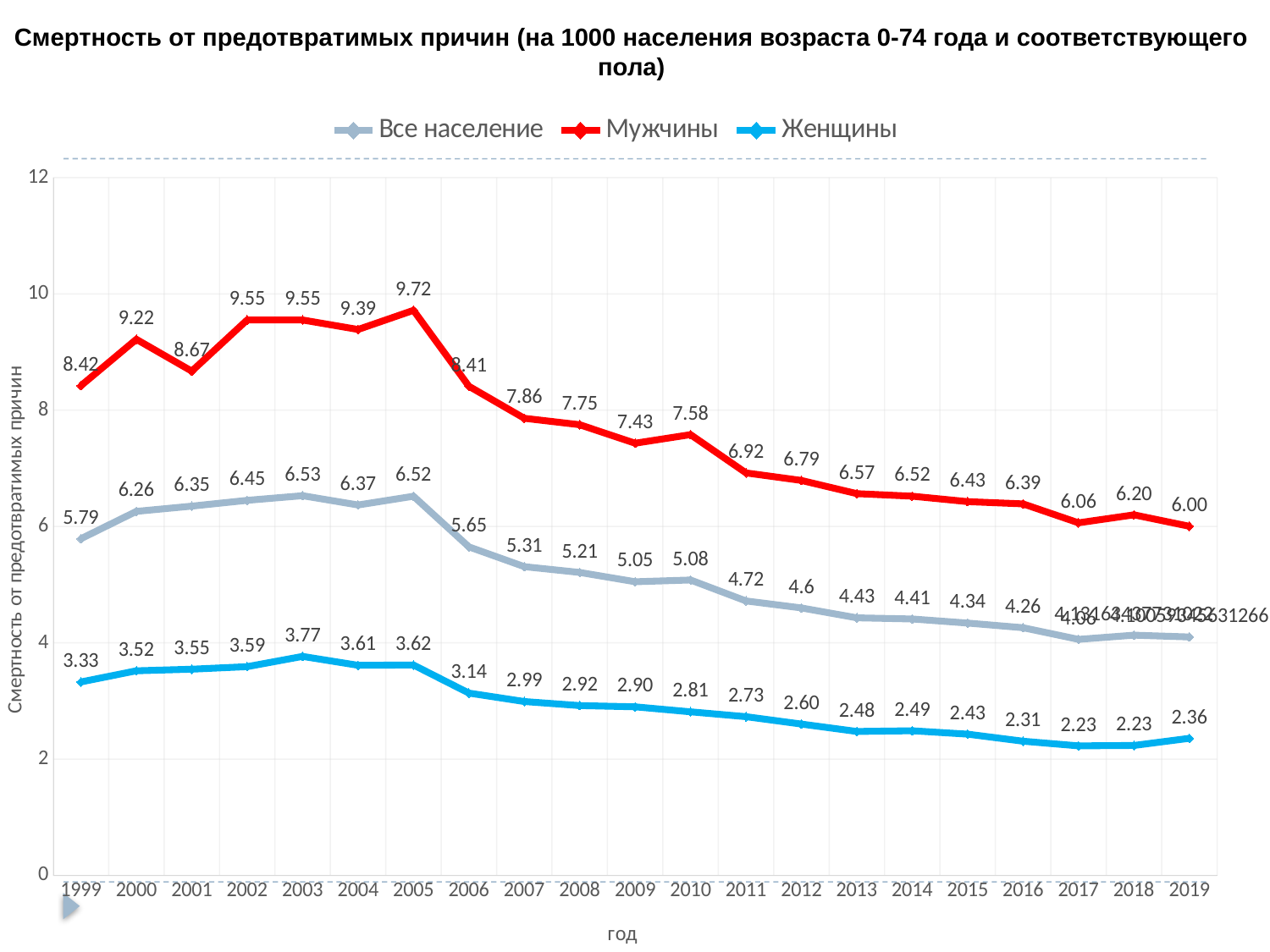
What is the difference between the Мужчины and Женщины values in 1999? 5.09 What is the value for Женщины in 1999? 3.33 In which year does the Мужчины series reach its highest value? 2005 What type of chart is shown on the slide? line chart What is the difference between the Мужчины values in 2005 and 2019? 3.72 What is the value for Мужчины in 2005? 9.72 How many series does the legend list? 3 In which year does the Женщины series reach its highest value? 2003 Which is larger: the Все население value in 2006 or in 2011? 2006 How many years are plotted along the x axis? 21 What is the value for Все население in 2003? 6.53 Overall, do the Мужчины values rise or fall from 2005 to 2019? fall